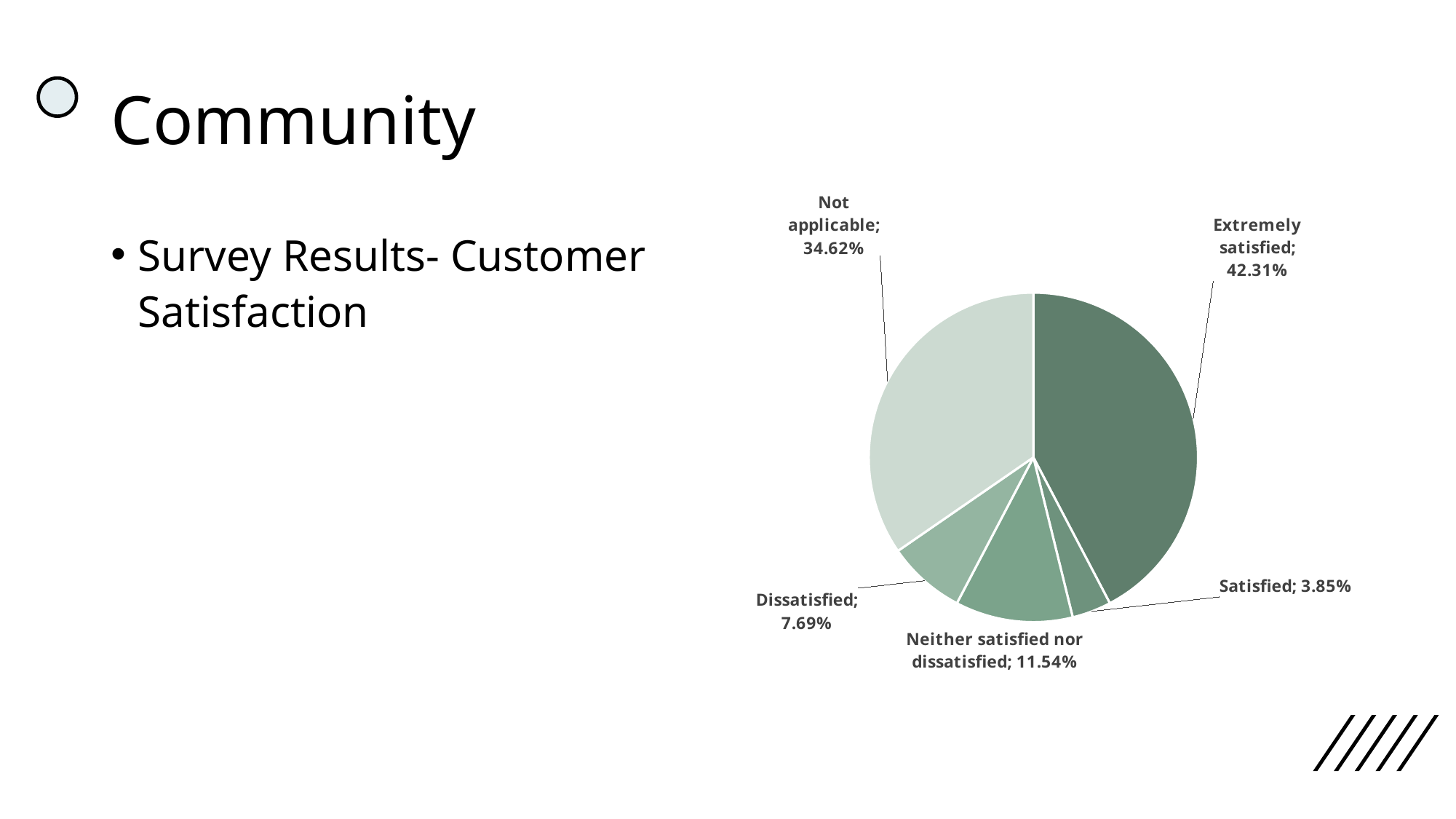
Which category has the smallest share of the pie? Satisfied How many slices does the pie chart have? 5 Which is larger, the share for Dissatisfied or the share for Neither satisfied nor dissatisfied? Neither satisfied nor dissatisfied What percentage of respondents were Extremely satisfied? 42.31% What percentage is shown for Neither satisfied nor dissatisfied? 11.54% What percentage of respondents were Dissatisfied? 7.69% Which category has the largest share of the pie? Extremely satisfied Which slice of the pie is the darkest green? Extremely satisfied What kind of chart is shown on the slide? pie chart What is the difference in percentage points between Extremely satisfied and Not applicable? 7.69 What percentage is shown for Not applicable? 34.62% What percentage of respondents were Satisfied? 3.85%